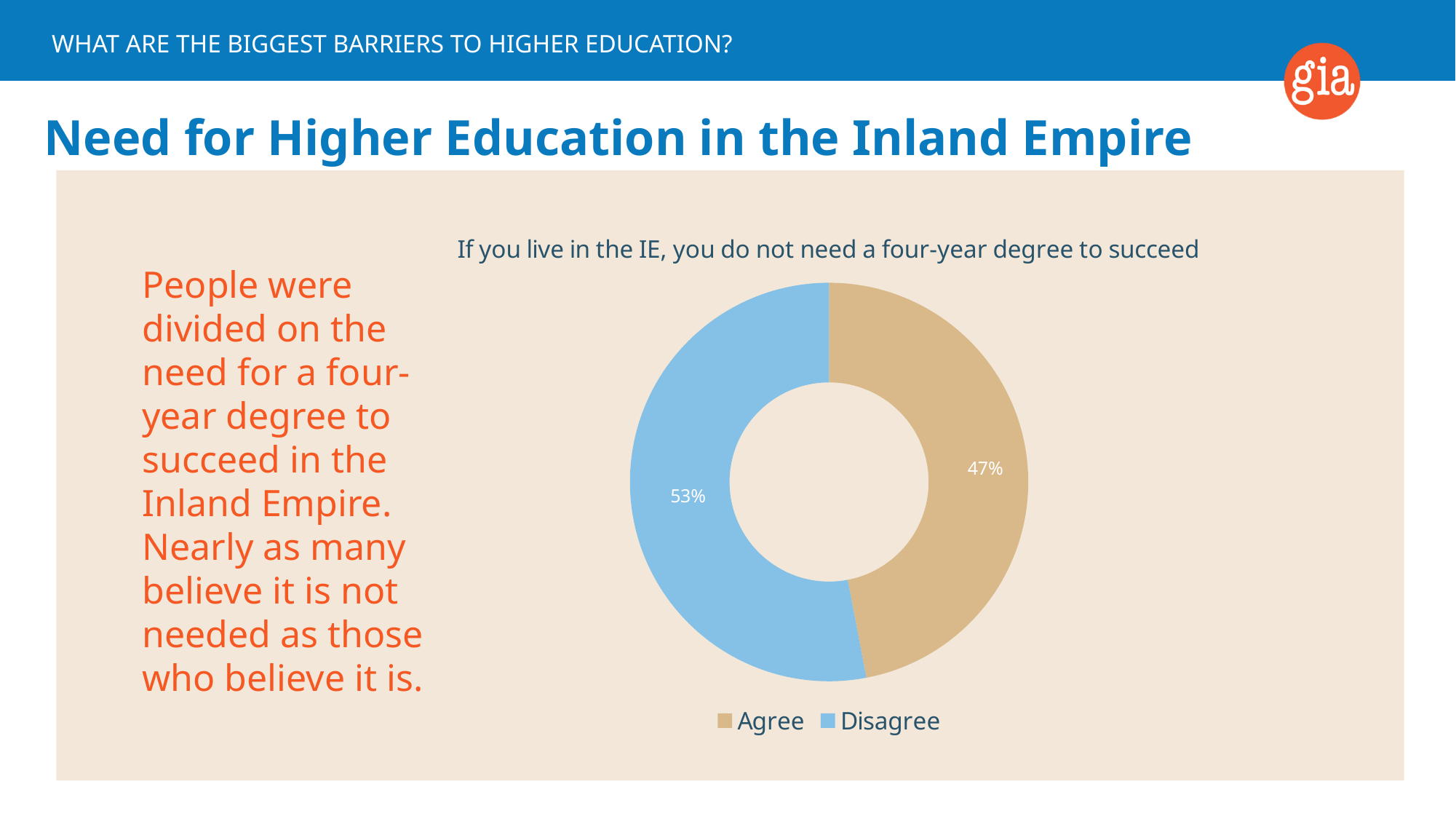
What colour represents Disagree in the chart? blue Which response has the larger share in the chart, Agree or Disagree? Disagree What share of the chart does the Agree slice represent? 47% What percentage of respondents agree that if you live in the IE, you do not need a four-year degree to succeed? 47% Which response has the smaller share in the chart? Agree Is the value for Disagree greater or less than 50%? greater Is the Agree share larger or smaller than the Disagree share? smaller What kind of chart is shown on the slide? doughnut chart What percentage of respondents disagree with the statement in the chart? 53% What is the title of the chart? If you live in the IE, you do not need a four-year degree to succeed How many categories does the chart show? 2 What is the difference in percentage points between the Disagree and Agree shares? 6